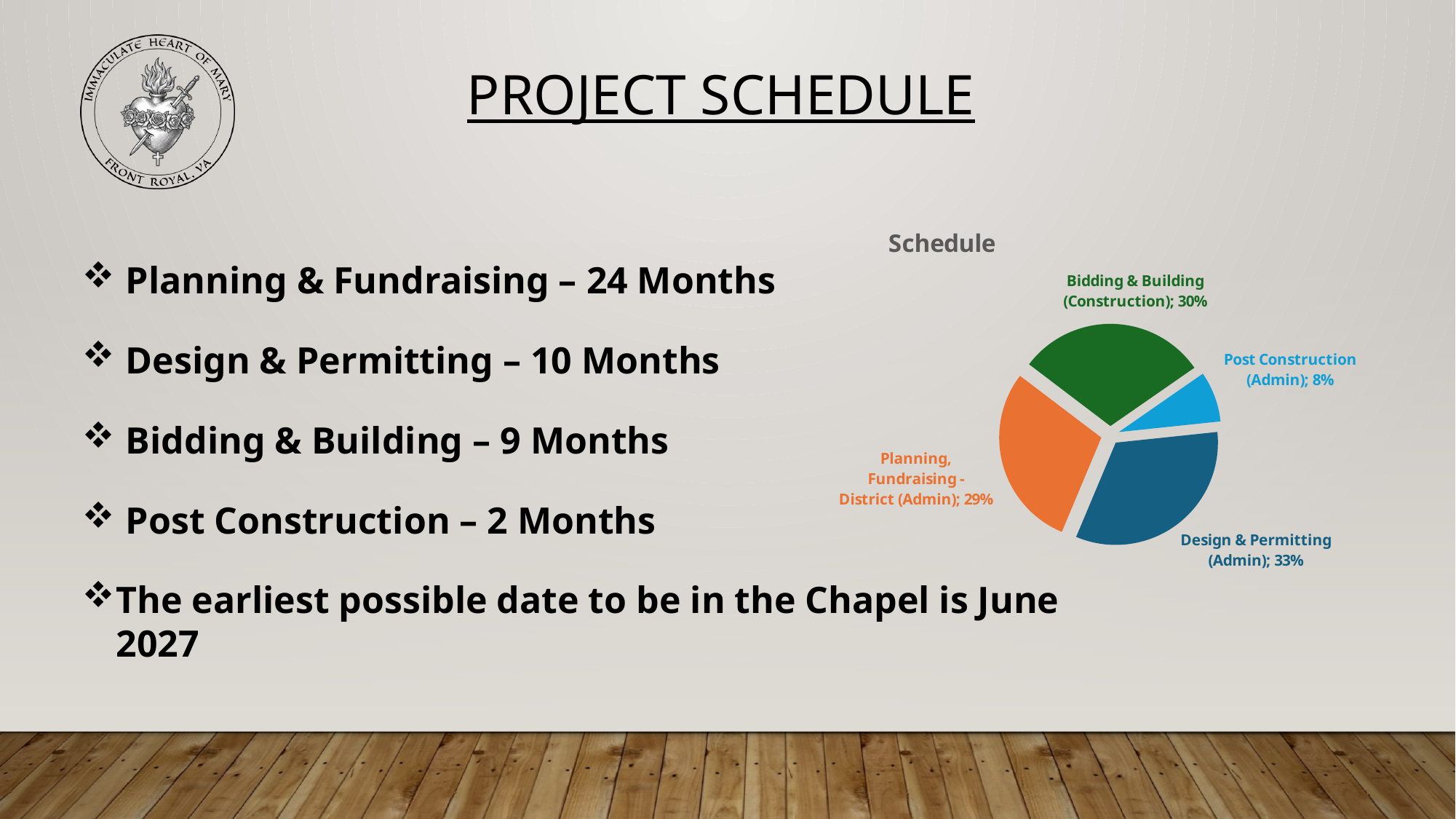
What kind of chart is shown on the slide? Pie chart What share of the pie is Planning, Fundraising - District (Admin)? 29% Which slice of the pie chart is the largest? Design & Permitting (Admin) What share of the pie is Post Construction (Admin)? 8% How many slices does the pie chart have? 4 Which is larger: Bidding & Building (Construction) or Planning, Fundraising - District (Admin)? Bidding & Building (Construction) What share of the pie is Design & Permitting (Admin)? 33% What is the title of the chart? Schedule What is the difference in percentage points between Design & Permitting (Admin) and Post Construction (Admin)? 25 Which slice of the pie chart is the smallest? Post Construction (Admin) What colour is the Post Construction (Admin) slice? Light blue